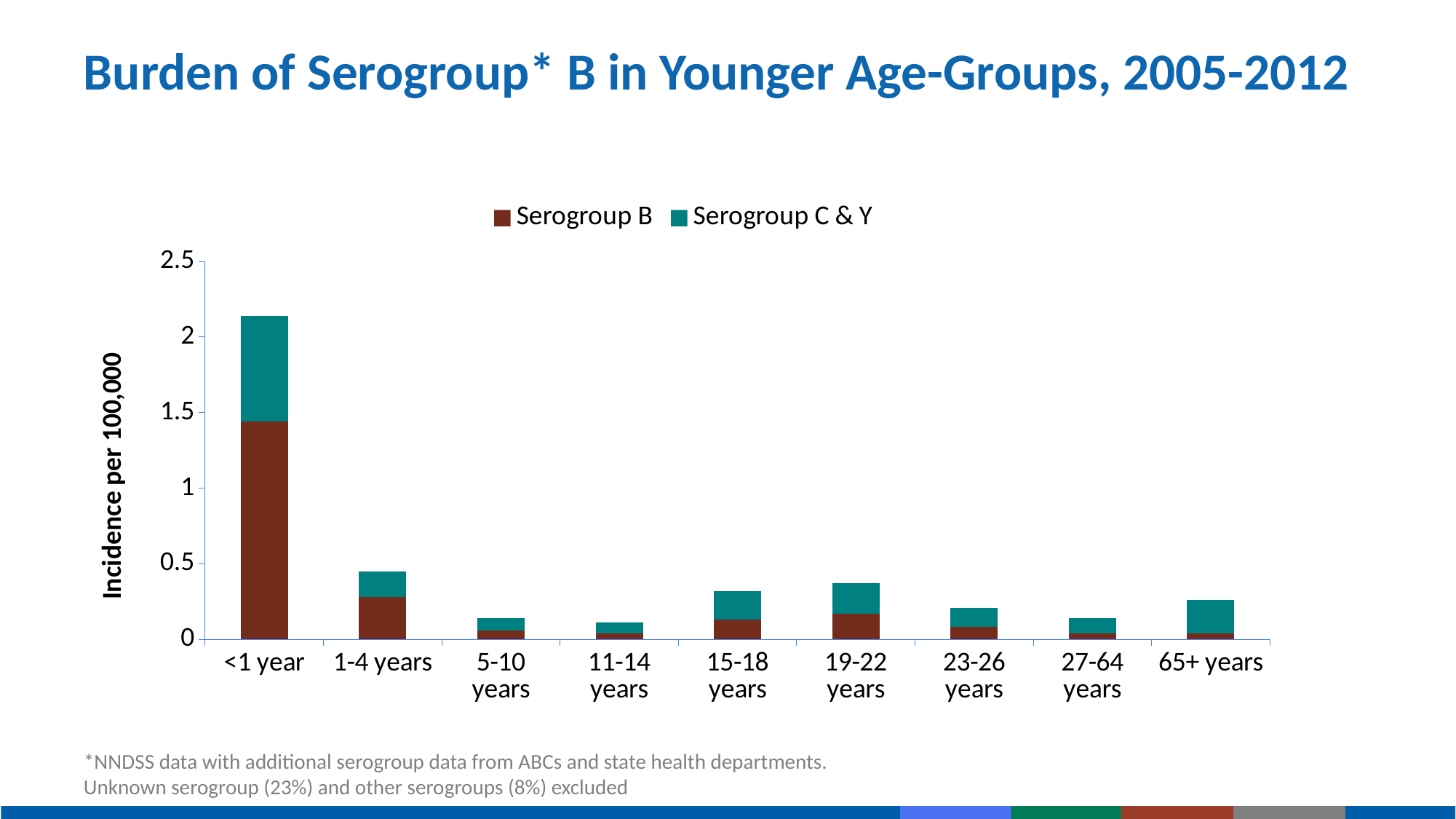
Which series is shown in teal in the legend? Serogroup C & Y Is the total incidence for <1 year greater or less than 2? greater What is the label of the y axis? Incidence per 100,000 Is the total incidence for 19-22 years greater or less than 0.5? less Is the Serogroup B incidence for <1 year greater or less than 1? greater Which has a larger total incidence, 19-22 years or 23-26 years? 19-22 years What kind of chart is shown on the slide? Stacked bar chart Which age group has the highest total incidence? <1 year How many series does the legend list? 2 Which has a larger total incidence, <1 year or 1-4 years? <1 year How many age-group categories are shown on the x axis? 9